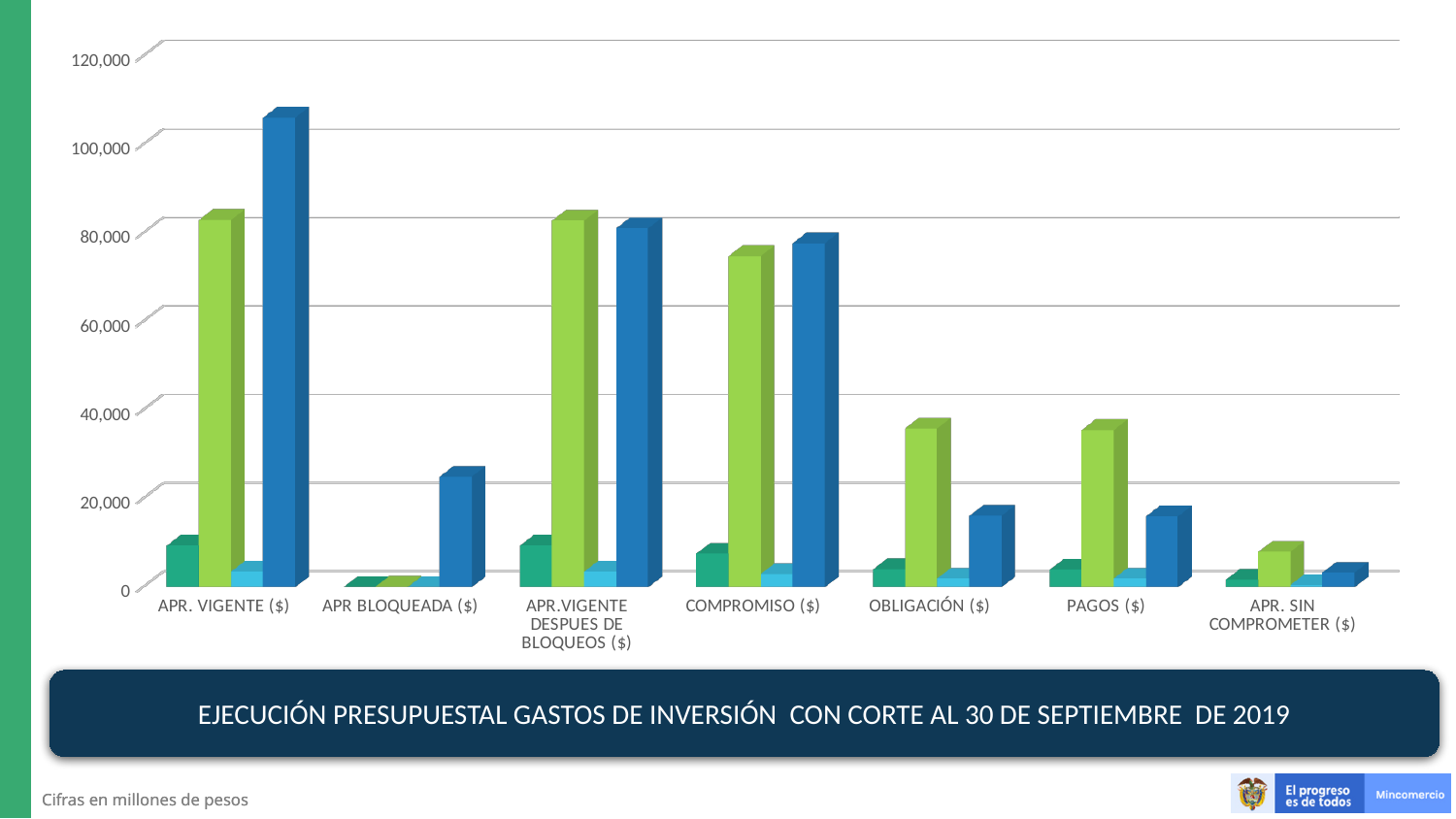
Is the tallest bar for APR. VIGENTE ($) greater or less than 100,000? greater Is the dark blue bar for APR BLOQUEADA ($) greater or less than 40,000? less Which is larger, the dark blue bar for APR. VIGENTE ($) or the dark blue bar for APR.VIGENTE DESPUES DE BLOQUEOS ($)? APR. VIGENTE ($) Is the light green bar for OBLIGACIÓN ($) greater or less than 20,000? greater What is the title shown in the box below the chart? EJECUCIÓN PRESUPUESTAL GASTOS DE INVERSIÓN CON CORTE AL 30 DE SEPTIEMBRE DE 2019 How many bars are plotted for each category in the chart? 4 What kind of chart is shown on the slide? bar chart Which is larger, the light green bar for OBLIGACIÓN ($) or the light green bar for APR. SIN COMPROMETER ($)? OBLIGACIÓN ($) Which category has the tallest bar in the chart? APR. VIGENTE ($) How many categories are shown on the x axis of the chart? 7